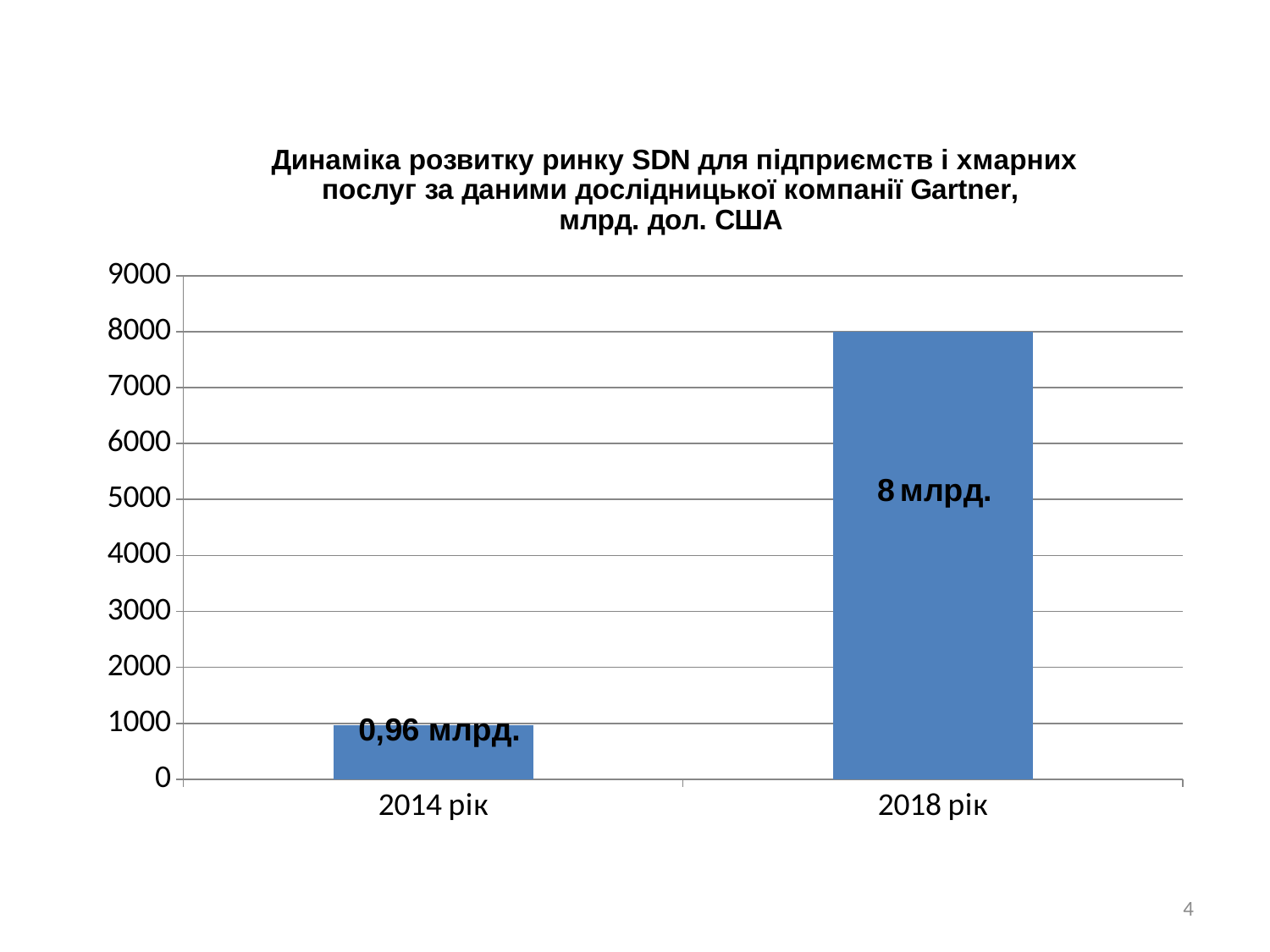
What is the highest value shown on the vertical axis of the chart? 9000 By how much does the labelled value for 2018 рік exceed the labelled value for 2014 рік? 7,04 млрд. Which is larger, the value for 2014 рік or the value for 2018 рік? 2018 рік How many categories are shown on the x axis of the chart? 2 Which year has the lowest value in the chart? 2014 рік Is the bar for 2018 рік greater or less than 7000 on the vertical axis? greater Which year has the highest value in the chart? 2018 рік What is the data label on the bar for 2018 рік? 8 млрд. What is the data label on the bar for 2014 рік? 0,96 млрд. What kind of chart is shown on the slide? bar chart Do the values rise or fall from 2014 рік to 2018 рік? rise